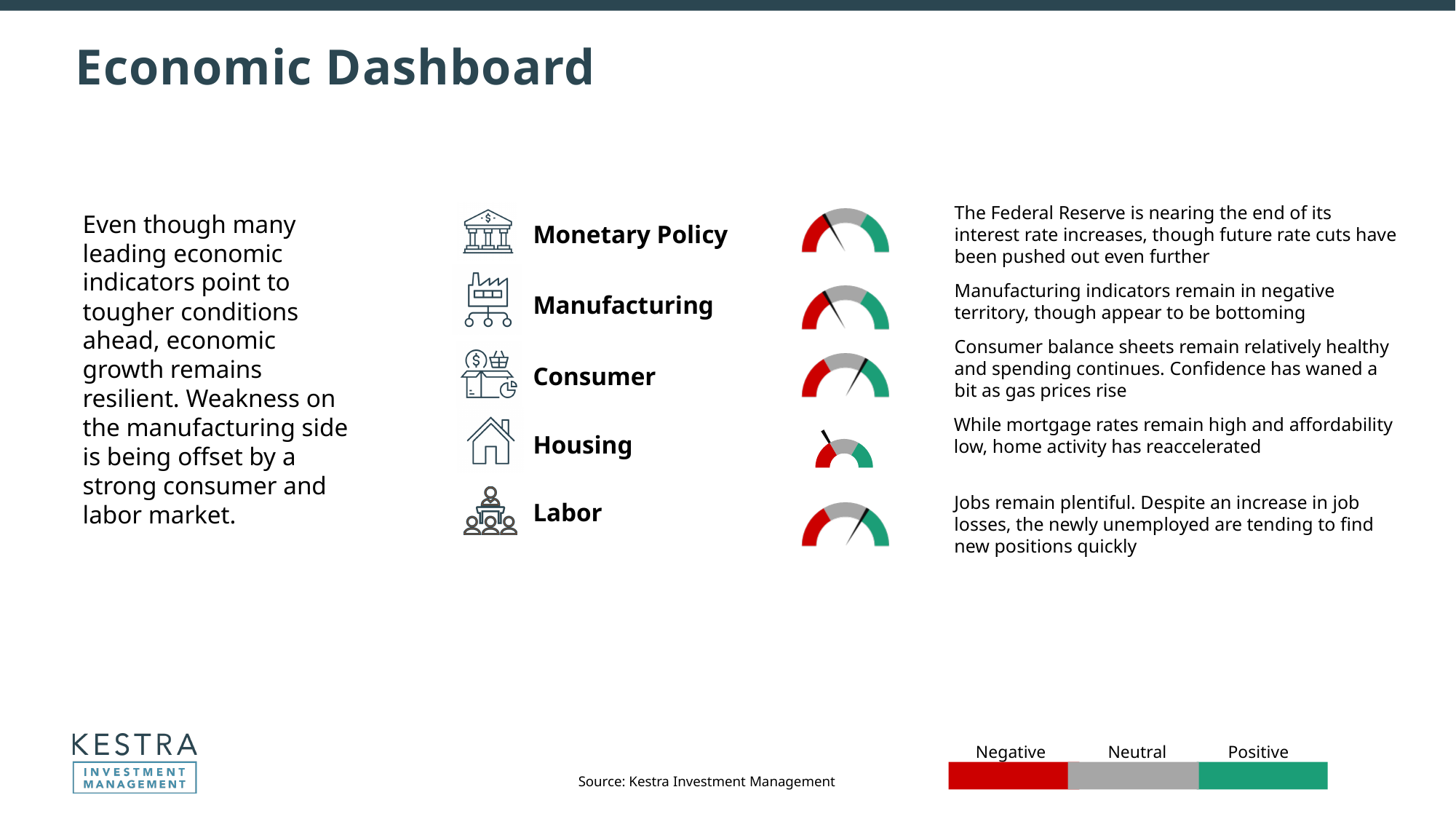
How many gauge charts are shown on the slide? 5 Is the Housing gauge needle in the Negative or Positive zone? Negative Which economic indicator's gauge needle points furthest into the Positive zone? Labor What is the title of the slide containing the gauge charts? Economic Dashboard Which economic indicator's gauge needle points furthest into the Negative zone? Housing Which gauge shows a more negative reading, Housing or Consumer? Housing What kind of chart is used to show the status of each economic indicator on the slide? Gauge chart Which gauge shows a more positive reading, Manufacturing or Labor? Labor Is the Labor gauge needle in the Negative or Positive zone? Positive Which colour represents 'Positive' in the gauge legend? Green How many categories does the colour legend at the bottom of the slide list? 3 What are the three categories in the colour legend at the bottom of the slide? Negative, Neutral, Positive